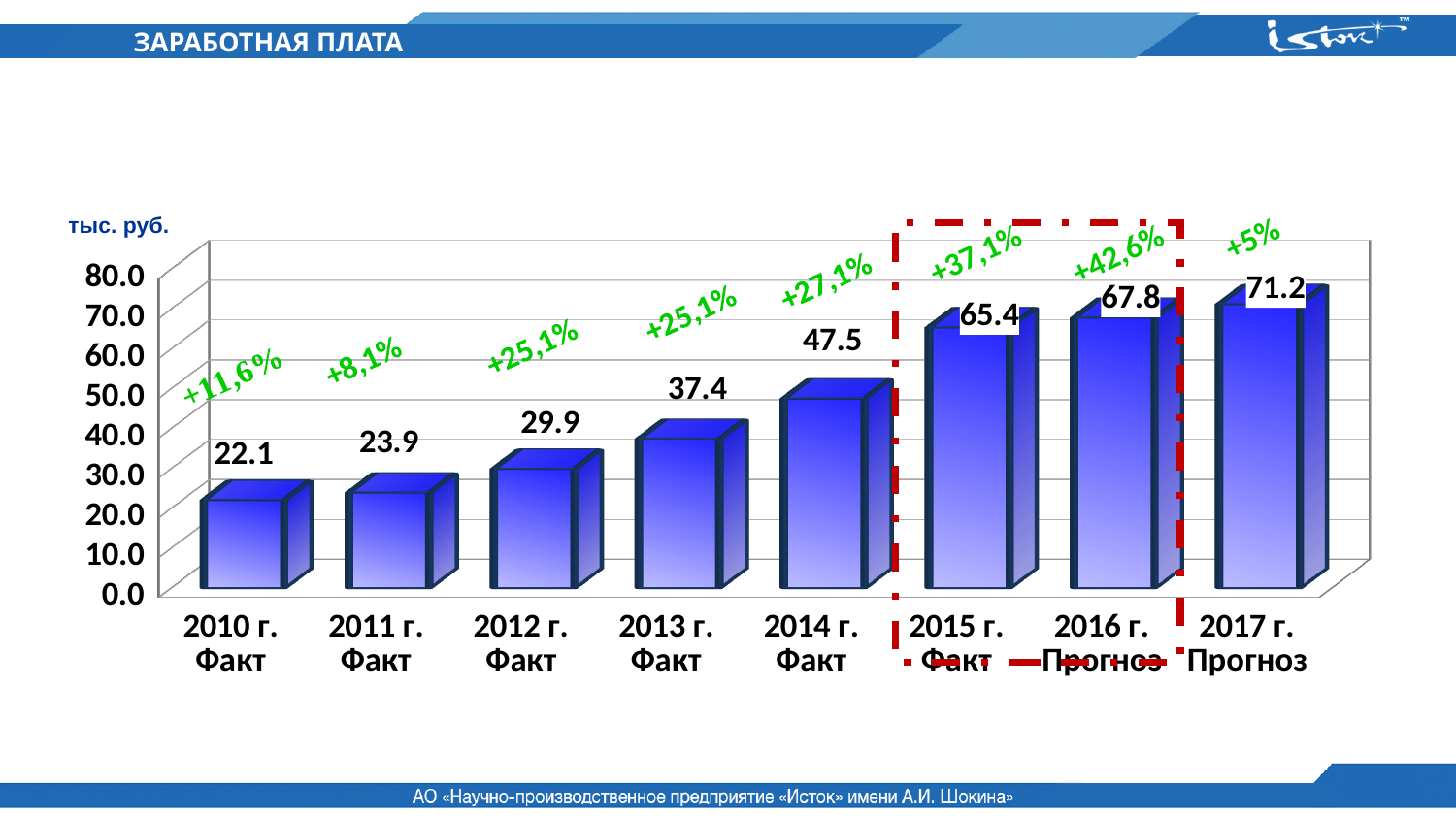
Which is larger, the value for 2012 г. Факт or 2011 г. Факт? 2012 г. Факт Do the values rise or fall from 2010 to 2017? Rise What kind of chart is shown on the slide? Bar chart What is the value for 2013 г. Факт? 37.4 What growth percentage is shown in green above the 2016 г. Прогноз bar? +42,6% What is the value for 2010 г. Факт? 22.1 How many years (bars) are shown on the chart? 8 What unit is shown on the vertical axis label? тыс. руб. Which year has the highest value? 2017 г. Прогноз What is the difference between the values for 2015 г. Факт and 2014 г. Факт? 17.9 Which year has the lowest value? 2010 г. Факт What is the value for 2016 г. Прогноз? 67.8